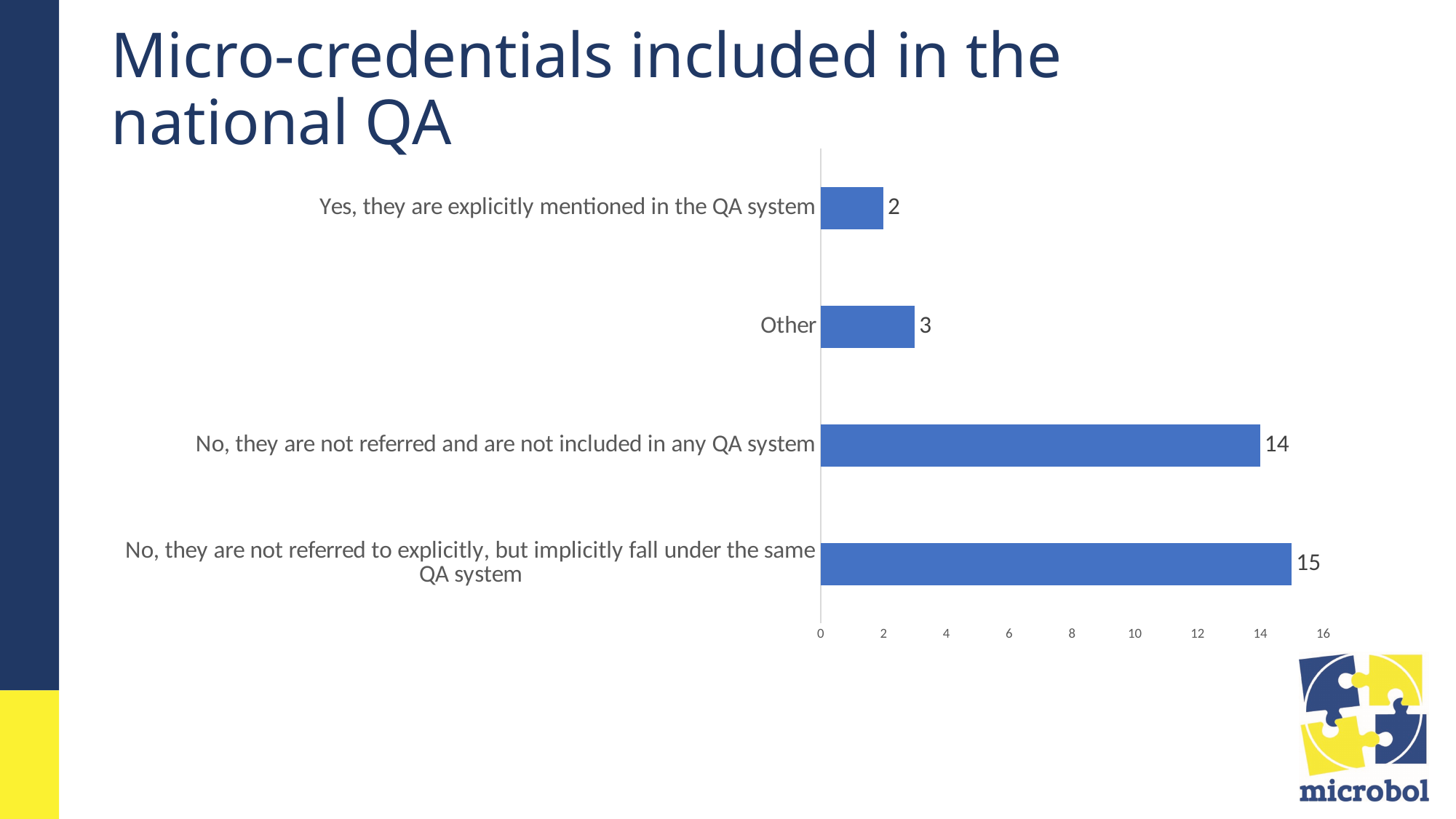
What is the title of the slide? Micro-credentials included in the national QA What kind of chart is shown on the slide? bar chart Which category has the highest value? No, they are not referred to explicitly, but implicitly fall under the same QA system What is the value for "No, they are not referred and are not included in any QA system"? 14 What is the value for "Yes, they are explicitly mentioned in the QA system"? 2 What is the value for "Other"? 3 How many categories are shown in the chart? 4 What is the difference between the values for "No, they are not referred and are not included in any QA system" and "Other"? 11 Is the value for "No, they are not referred and are not included in any QA system" greater or less than 10? greater Which is larger: the value for "Other" or the value for "Yes, they are explicitly mentioned in the QA system"? Other Which category has the lowest value? Yes, they are explicitly mentioned in the QA system What is the value for "No, they are not referred to explicitly, but implicitly fall under the same QA system"? 15